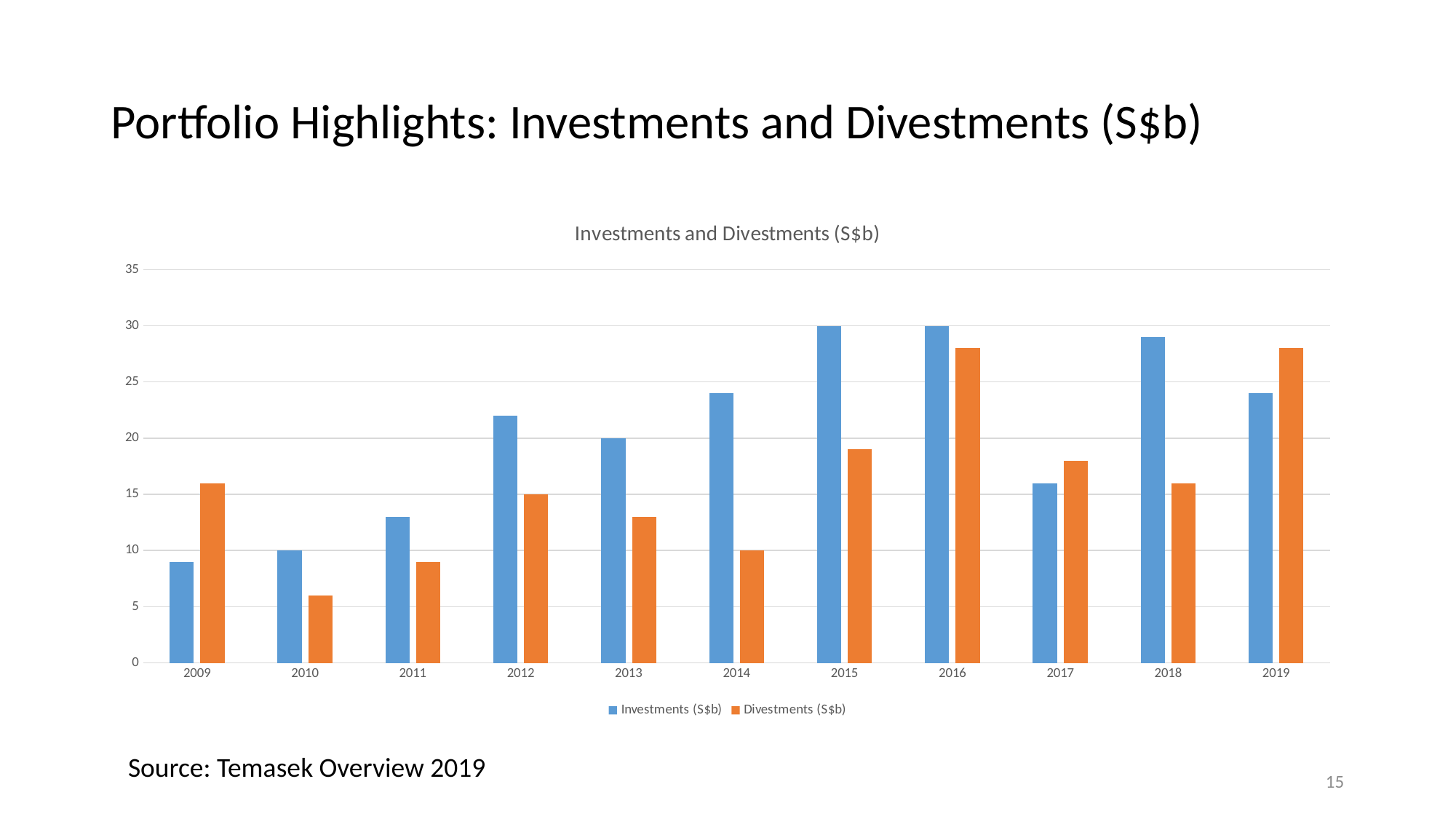
What type of chart is shown on the slide? bar chart Is the value of Divestments (S$b) for 2011 greater or less than 10? less In 2009, which is larger: Investments or Divestments? Divestments What is the value of Investments (S$b) for 2010? 10 What is the value of Divestments (S$b) for 2014? 10 What is the value of Investments (S$b) for 2013? 20 Which year has the lowest Divestments (S$b)? 2010 How many years are shown on the x axis? 11 In 2014, which is larger: Investments or Divestments? Investments Which colour represents Divestments (S$b) in the chart? orange Is the value of Investments (S$b) for 2018 greater or less than 25? greater How many series does the legend list? 2